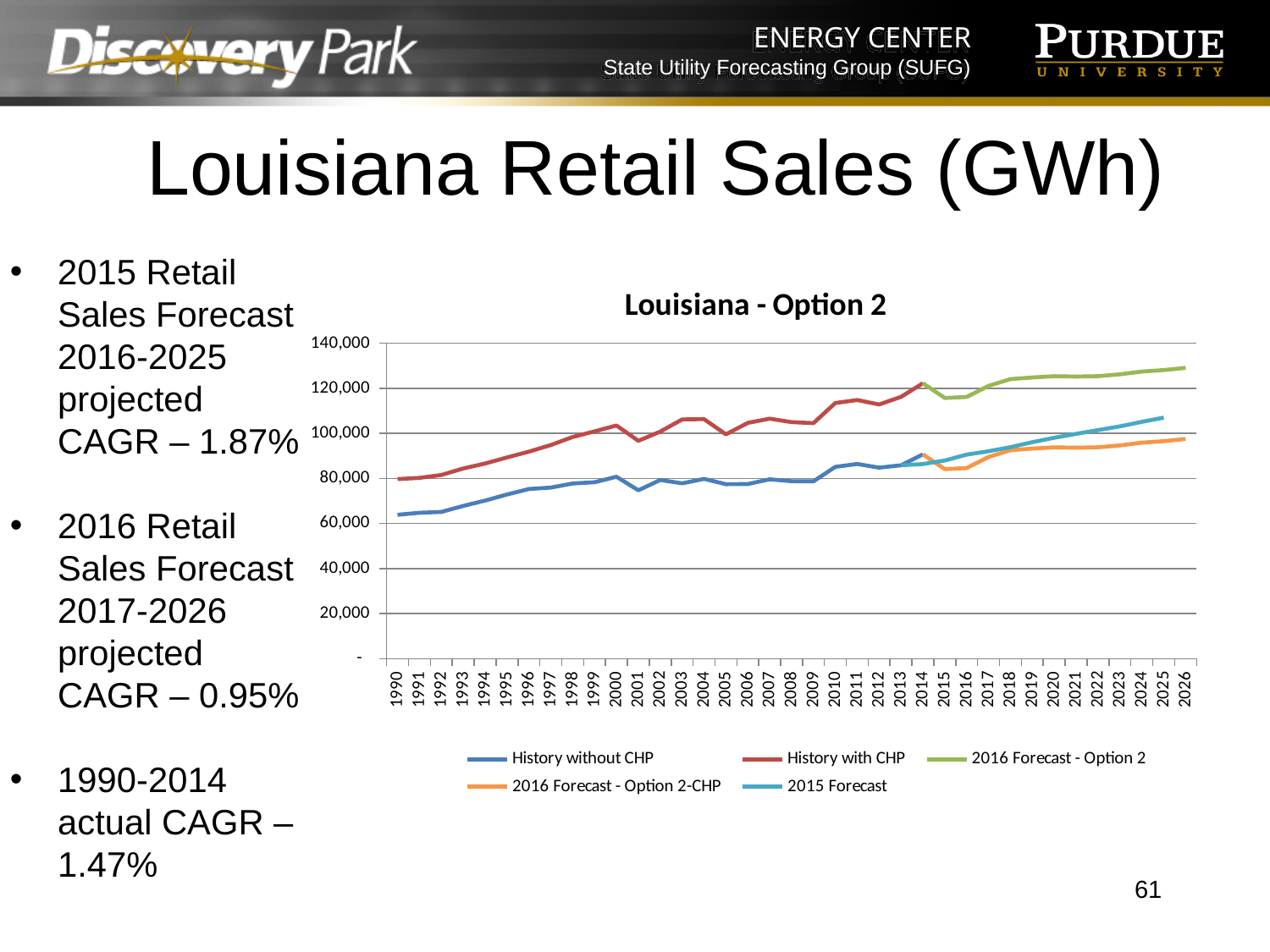
Is the value for 2016 Forecast - Option 2 in 2026 greater or less than 120,000? greater How many years are shown along the x axis of the chart? 37 Is the value for History without CHP in 1990 greater or less than 80,000? less Which series reaches the highest value on the chart? 2016 Forecast - Option 2 How many series does the chart legend list? 5 Does the History without CHP series generally rise or fall from 1990 to 2014? rise In 2025, which is larger: 2016 Forecast - Option 2 or 2016 Forecast - Option 2-CHP? 2016 Forecast - Option 2 In 2010, which is larger: History with CHP or History without CHP? History with CHP What kind of chart is shown on the slide? line chart Is the value for History with CHP in 2010 greater or less than 100,000? greater What is the title of the chart? Louisiana - Option 2